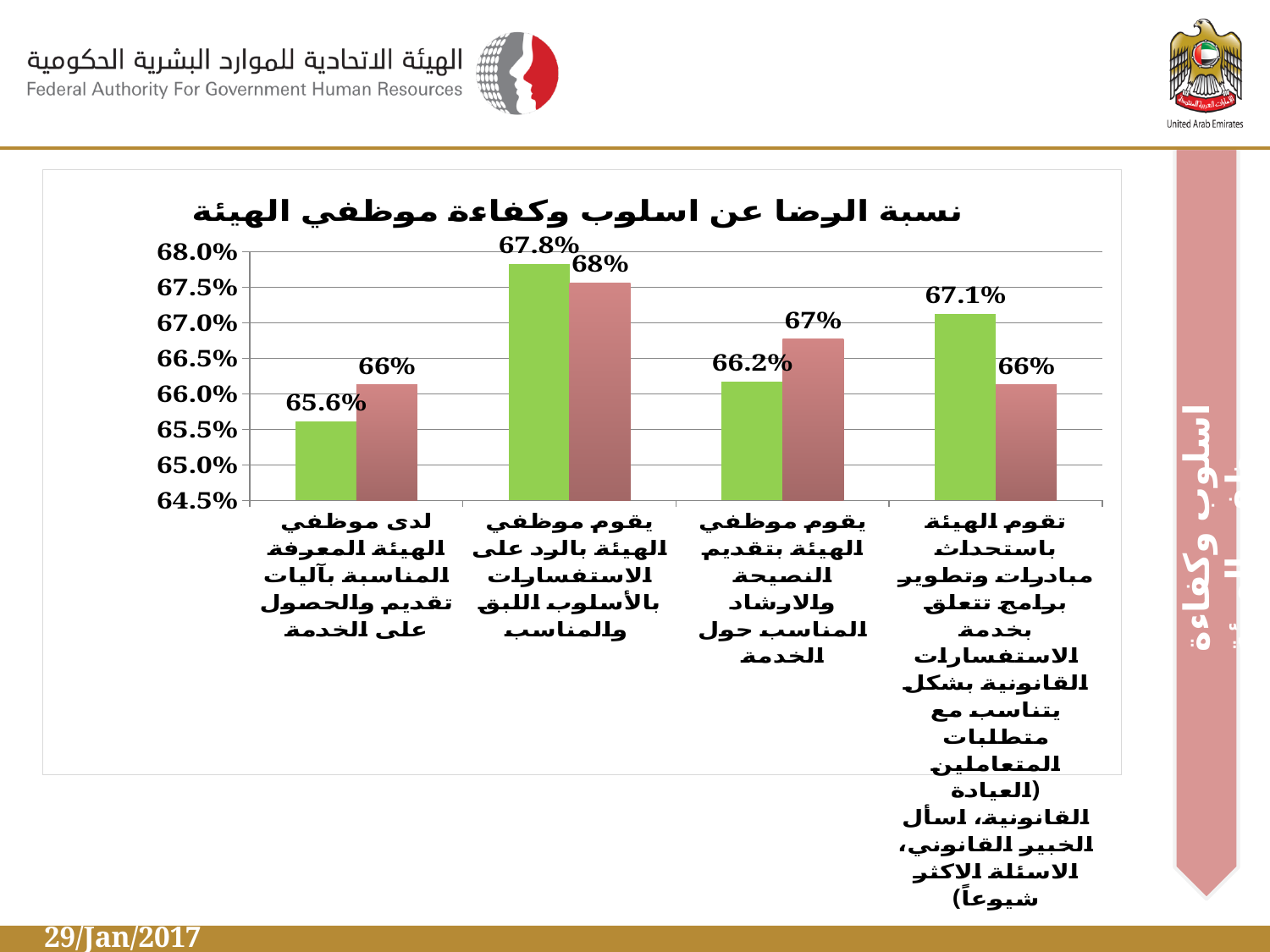
What is the value of the pink bar for the category 'يقوم موظفي الهيئة بالرد على الاستفسارات بالأسلوب اللبق والمناسب'? 68% Which category has the highest green bar? يقوم موظفي الهيئة بالرد على الاستفسارات بالأسلوب اللبق والمناسب What is the value of the green bar for the category 'يقوم موظفي الهيئة بتقديم النصيحة والارشاد المناسب حول الخدمة'? 66.2% What is the difference between the green bar values for 'يقوم موظفي الهيئة بالرد على الاستفسارات بالأسلوب اللبق والمناسب' and 'لدى موظفي الهيئة المعرفة المناسبة بآليات تقديم والحصول على الخدمة'? 2.2% What is the value of the green bar for the category 'لدى موظفي الهيئة المعرفة المناسبة بآليات تقديم والحصول على الخدمة'? 65.6% For the category 'يقوم موظفي الهيئة بتقديم النصيحة والارشاد المناسب حول الخدمة', which bar is larger, the green bar or the pink bar? the pink bar What is the title of the chart? نسبة الرضا عن اسلوب وكفاءة موظفي الهيئة Which category has the highest pink bar? يقوم موظفي الهيئة بالرد على الاستفسارات بالأسلوب اللبق والمناسب What kind of chart is shown on the slide? bar chart Which category has the lowest green bar? لدى موظفي الهيئة المعرفة المناسبة بآليات تقديم والحصول على الخدمة Is the value of the pink bar for 'يقوم موظفي الهيئة بالرد على الاستفسارات بالأسلوب اللبق والمناسب' greater or less than 67.5%? greater How many categories are shown on the x axis of the chart? 4